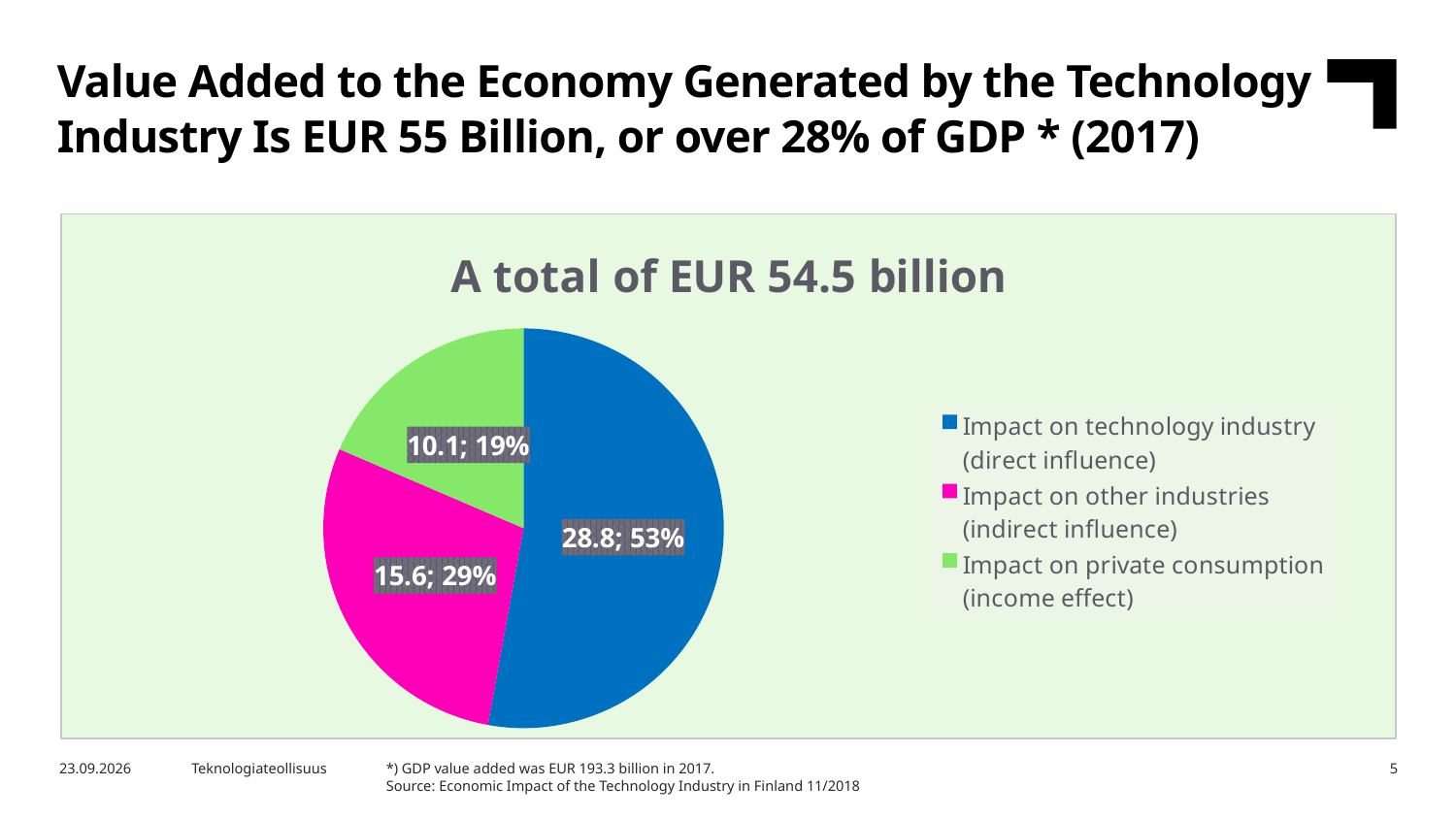
What kind of chart is shown on the slide? pie chart What is the chart's title? A total of EUR 54.5 billion What share of the pie does Impact on technology industry (direct influence) represent? 53% Which category has the largest slice? Impact on technology industry (direct influence) What share of the pie does Impact on private consumption (income effect) represent? 19% What value is shown for Impact on private consumption (income effect)? 10.1 How many slices does the pie chart have? 3 Which category has the smallest slice? Impact on private consumption (income effect) What is the difference between the values for Impact on technology industry (direct influence) and Impact on other industries (indirect influence)? 13.2 How many entries does the legend list? 3 What value is shown for Impact on technology industry (direct influence)? 28.8 What value is shown for Impact on other industries (indirect influence)? 15.6